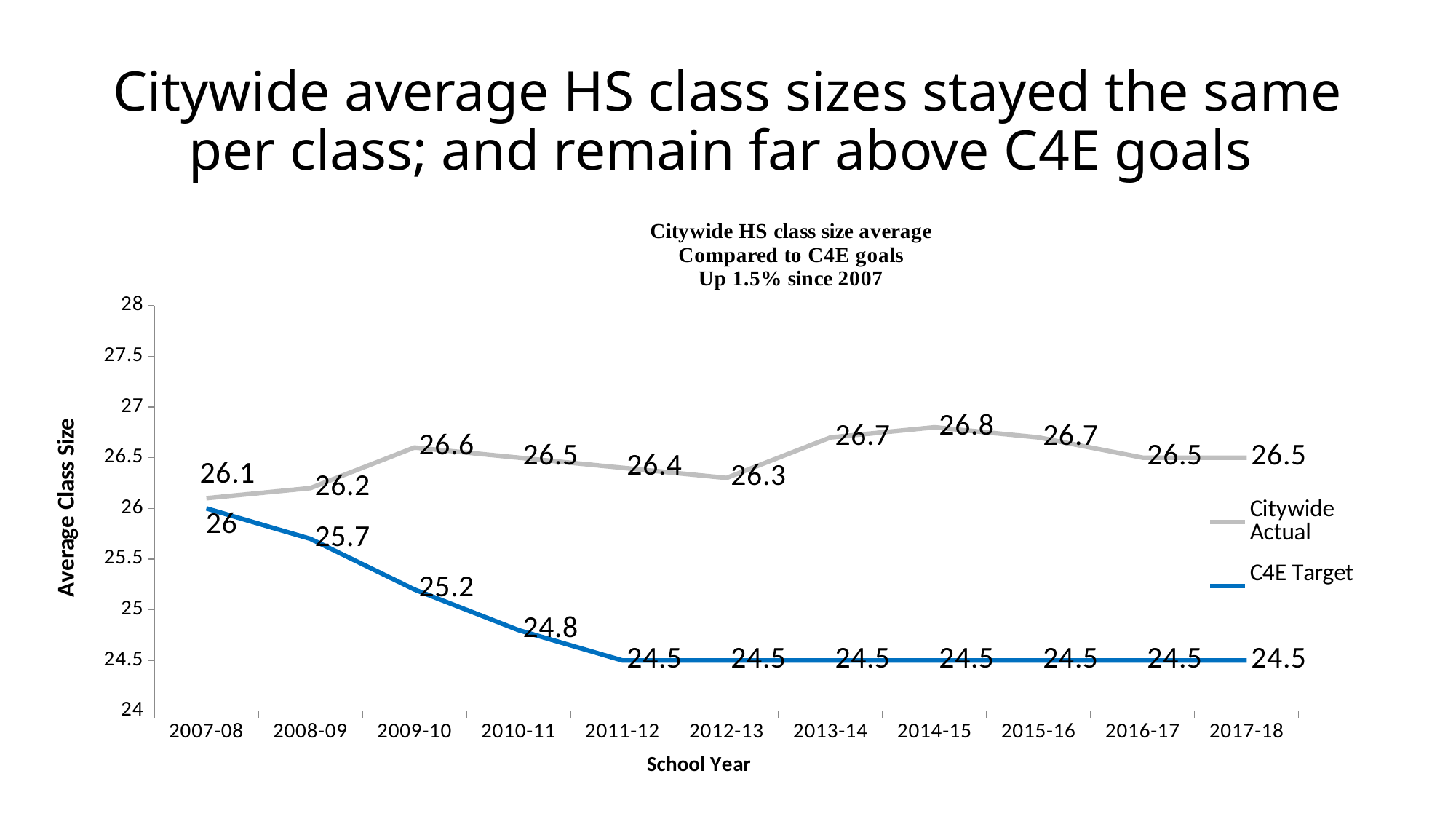
What is the Citywide Actual average class size for 2014-15? 26.8 What is the difference between the Citywide Actual and C4E Target values in 2017-18? 2 Which is larger in 2012-13, the Citywide Actual value or the C4E Target value? Citywide Actual How many school years are shown on the x axis? 11 In which school year is the Citywide Actual average class size lowest? 2007-08 What is the C4E Target value for 2008-09? 25.7 Does the C4E Target line rise or fall from 2007-08 to 2011-12? Fall What kind of chart is shown on the slide? Line chart What is the label of the y axis? Average Class Size In which school year is the Citywide Actual average class size highest? 2014-15 What is the Citywide Actual value for 2007-08? 26.1 How many series does the legend list? 2